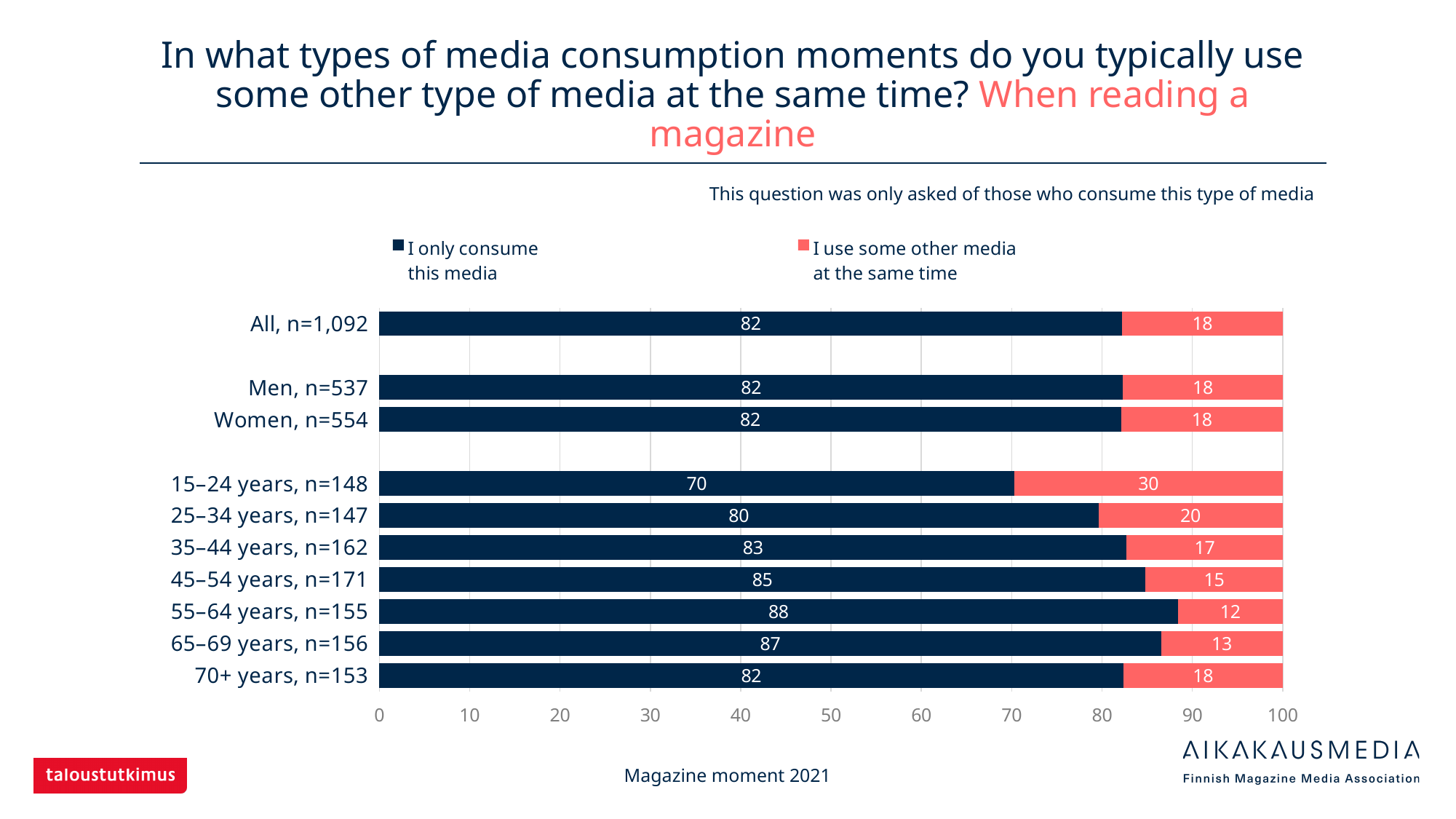
What is the value of "I only consume this media" for 15–24 years, n=148? 70 What is the value of "I only consume this media" for Women, n=554? 82 What kind of chart is shown on the slide? Stacked bar chart What is the value of "I use some other media at the same time" for 55–64 years, n=155? 12 Which category has the lowest value for "I only consume this media"? 15–24 years, n=148 Which is larger: the "I only consume this media" value for 55–64 years, n=155 or for 65–69 years, n=156? 55–64 years, n=155 Which category has the highest value for "I use some other media at the same time"? 15–24 years, n=148 What is the difference between the "I use some other media at the same time" values for 15–24 years, n=148 and 25–34 years, n=147? 10 How many categories are shown on the chart? 10 How many series does the legend list? 2 What is the total of the stacked bar for 45–54 years, n=171? 100 What colour represents "I use some other media at the same time" in the chart? Red (coral)